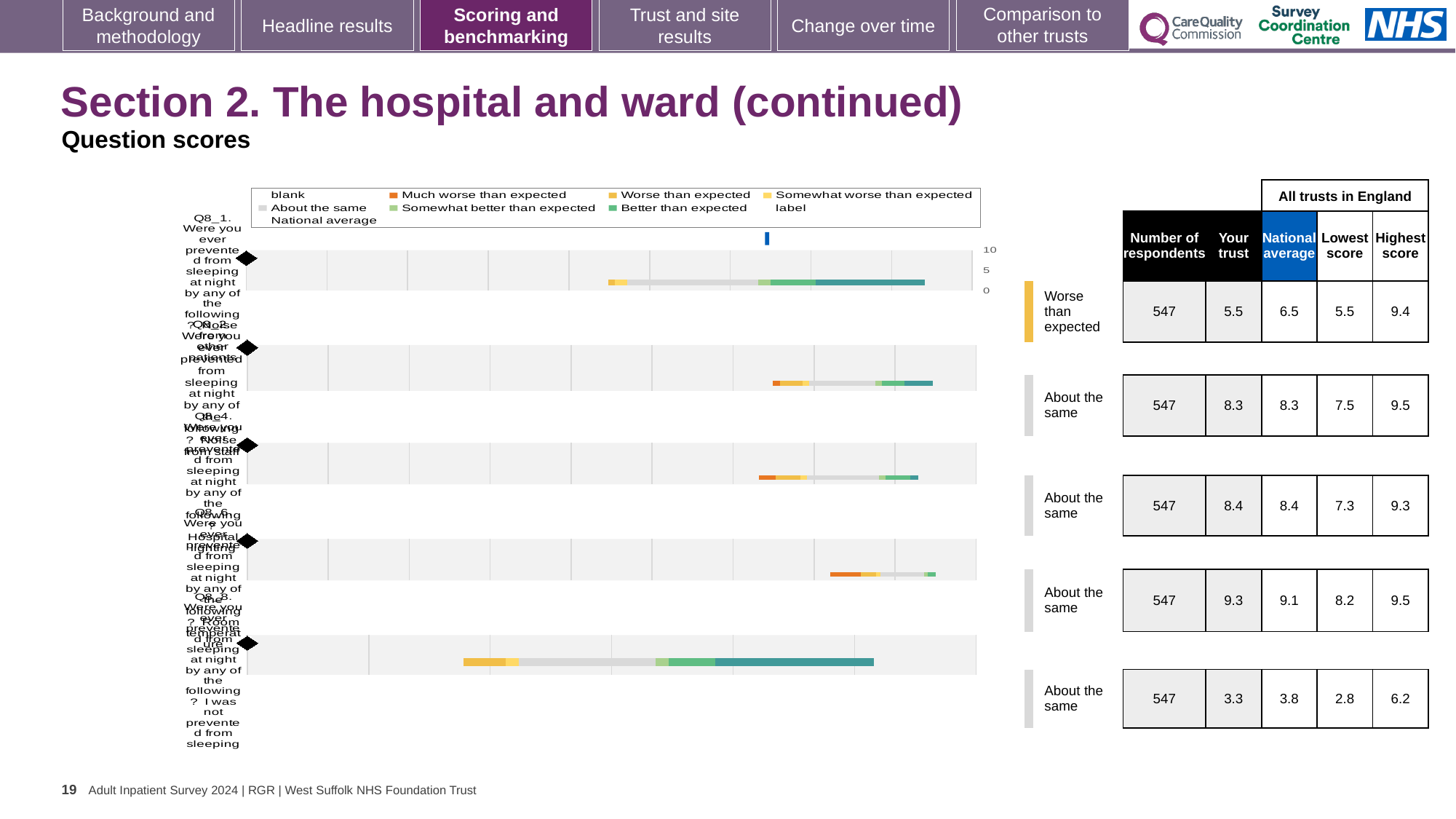
What kind of chart is shown on the slide? bar chart How many rows in the table next to the chart are labelled 'About the same'? 4 In the table next to the chart, what is the difference between 'Your trust' and 'National average' in the first row? 1.0 In the table next to the chart, what is the 'Your trust' score in the first row (labelled 'Worse than expected')? 5.5 In the table next to the chart, what is the 'Number of respondents' in the second row? 547 In the table next to the chart, what is the 'Highest score' in the last row? 6.2 In the table next to the chart, what is the 'National average' in the first row (labelled 'Worse than expected')? 6.5 What is the highest tick value shown on the chart's axis? 10 Which legend entry is shown in orange in the chart's legend? Much worse than expected In the table next to the chart, which is larger in the fourth row: 'Your trust' or 'National average'? Your trust How many horizontal bars are plotted in the chart? 5